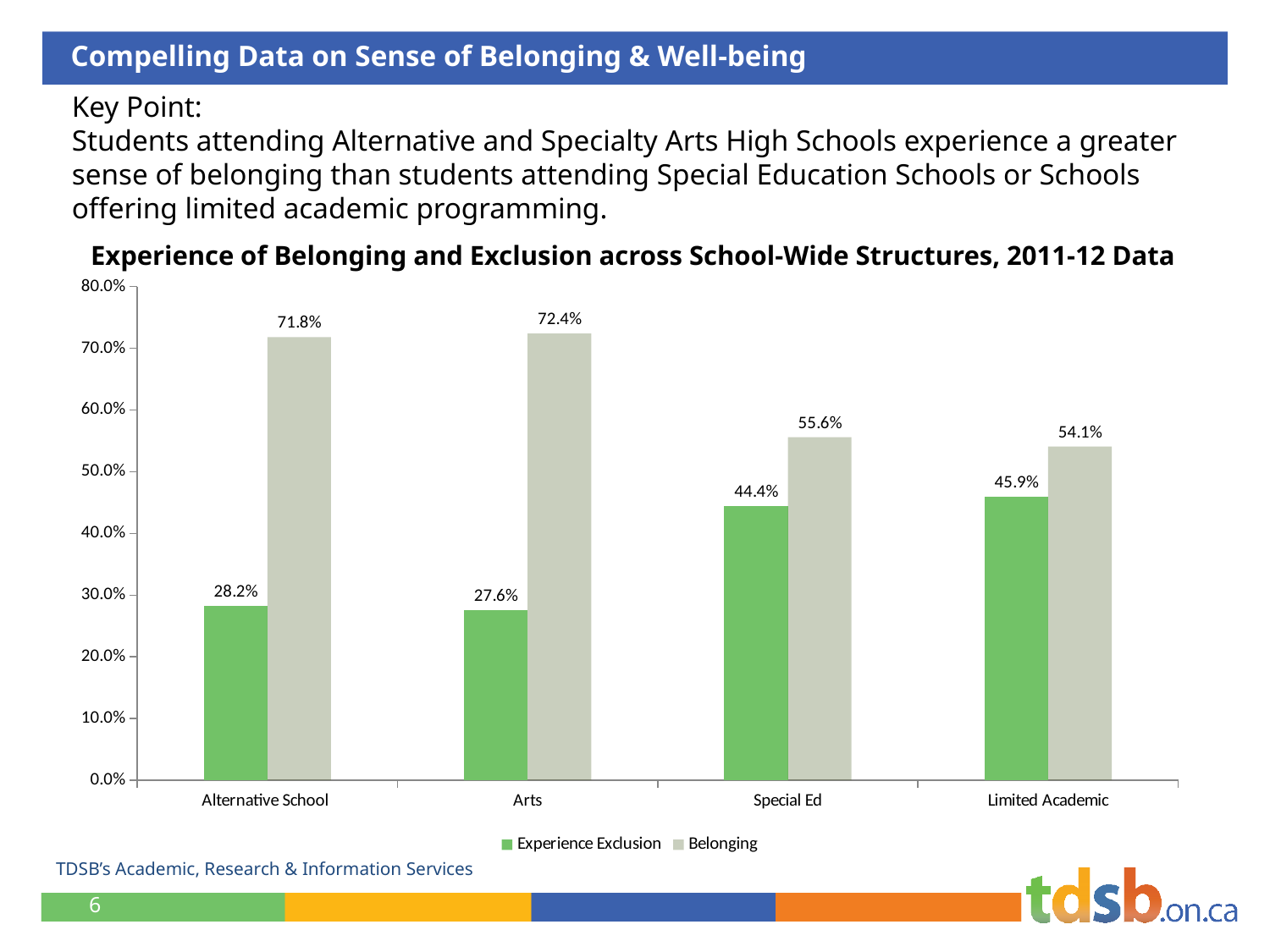
Which is larger: the Experience Exclusion value for Limited Academic or for Alternative School? Limited Academic What is the Belonging value for Limited Academic? 54.1% Is the Belonging value for Special Ed greater or less than 50.0%? greater What kind of chart is shown on the slide? Bar chart What is the title of the chart? Experience of Belonging and Exclusion across School-Wide Structures, 2011-12 Data How many series does the legend list? 2 What is the Experience Exclusion value for Special Ed? 44.4% What is the difference between the Belonging and Experience Exclusion values for Special Ed? 11.2% Which category has the highest Belonging value? Arts Which category has the lowest Experience Exclusion value? Arts How many categories are shown on the x axis? 4 What is the Belonging value for Alternative School? 71.8%